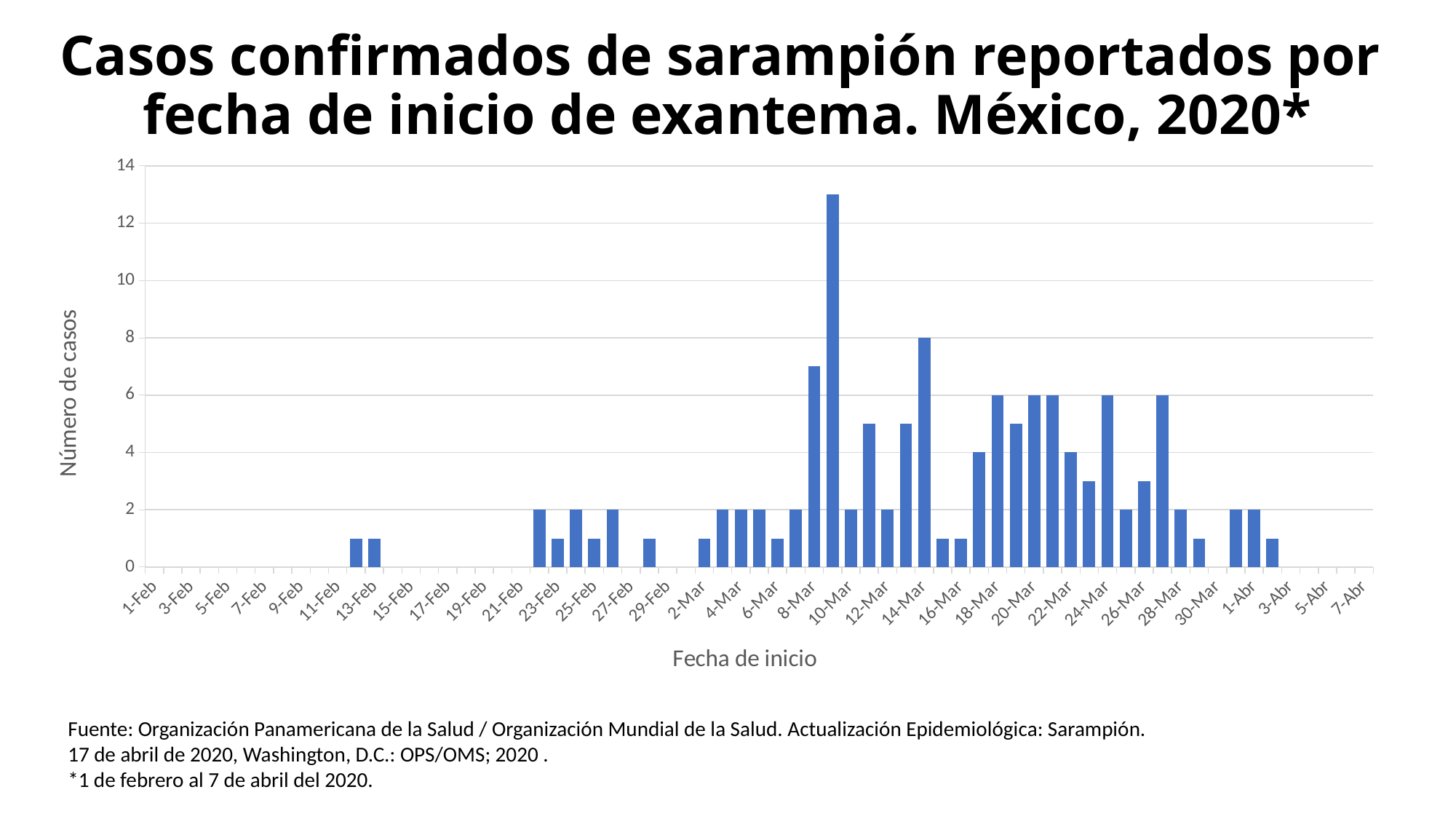
Is the value of the tallest bar in the chart greater or less than 12? greater Is the value for 8-Mar greater or less than 6? greater What is the difference between the number of cases on 14-Mar and on 18-Mar? 2 What is the title of the horizontal axis of the chart? Fecha de inicio Which date has more cases, 14-Mar or 18-Mar? 14-Mar Is the value for 2-Mar greater or less than 2? less How many cases are shown for 22-Mar? 4 How many cases are shown for 18-Mar? 6 What is the title of the vertical axis of the chart? Número de casos What type of chart is shown on the slide? bar chart How many cases are shown for 4-Mar? 2 How many cases are shown for 14-Mar? 8